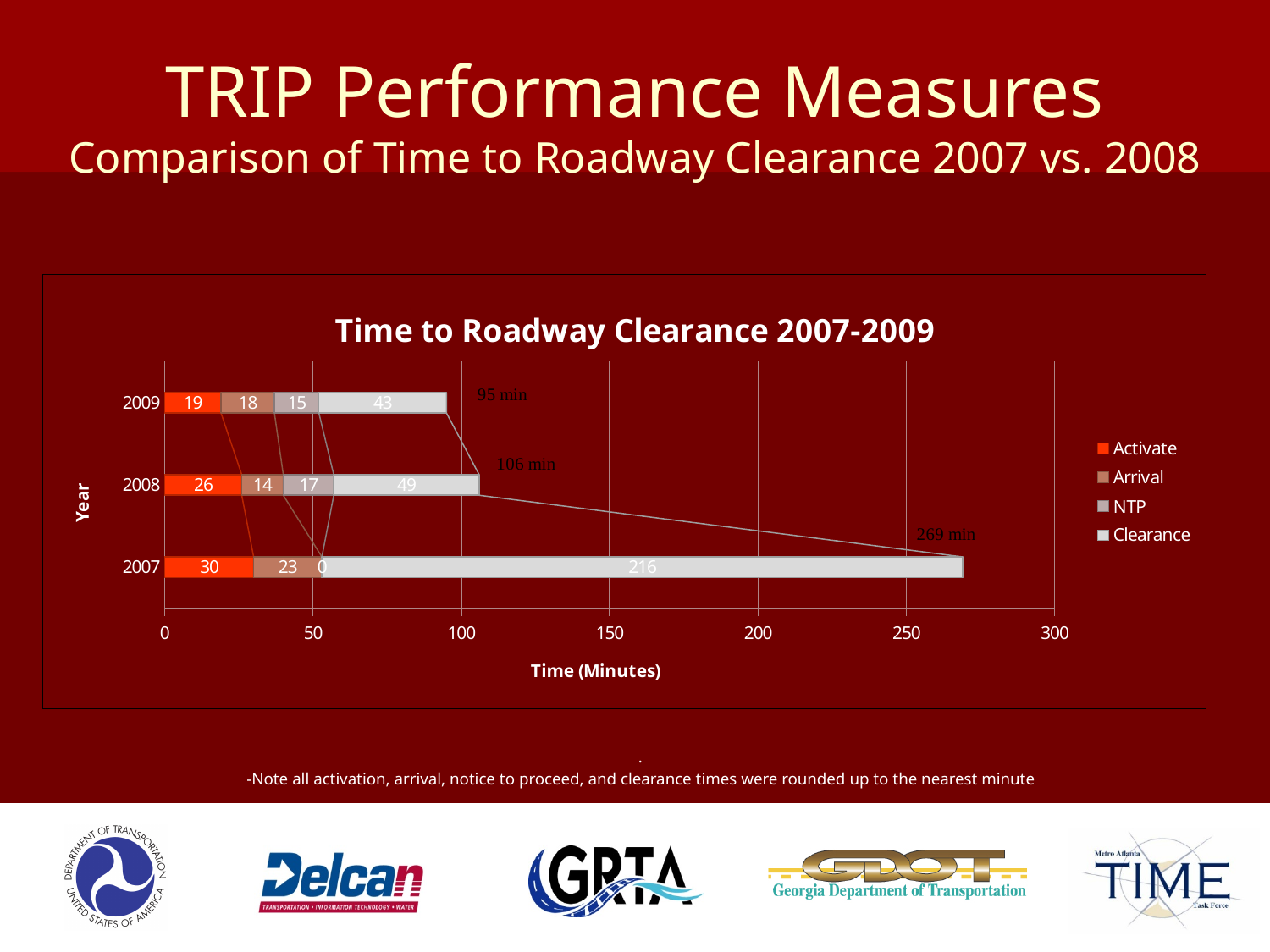
Which year has the highest total time to roadway clearance? 2007 What is the Clearance value for 2007? 216 What kind of chart is shown on the slide? Stacked bar chart What is the total time to roadway clearance for 2009? 95 min How many series does the chart legend list? 4 Which year has the lowest Activate value? 2009 How many years are plotted on the chart? 3 What is the Activate value for 2008? 26 What is the title of the chart? Time to Roadway Clearance 2007-2009 What is the NTP value for 2009? 15 What is the difference between the Clearance values for 2008 and 2009? 6 Which is larger, the Arrival value for 2007 or the Arrival value for 2008? 2007